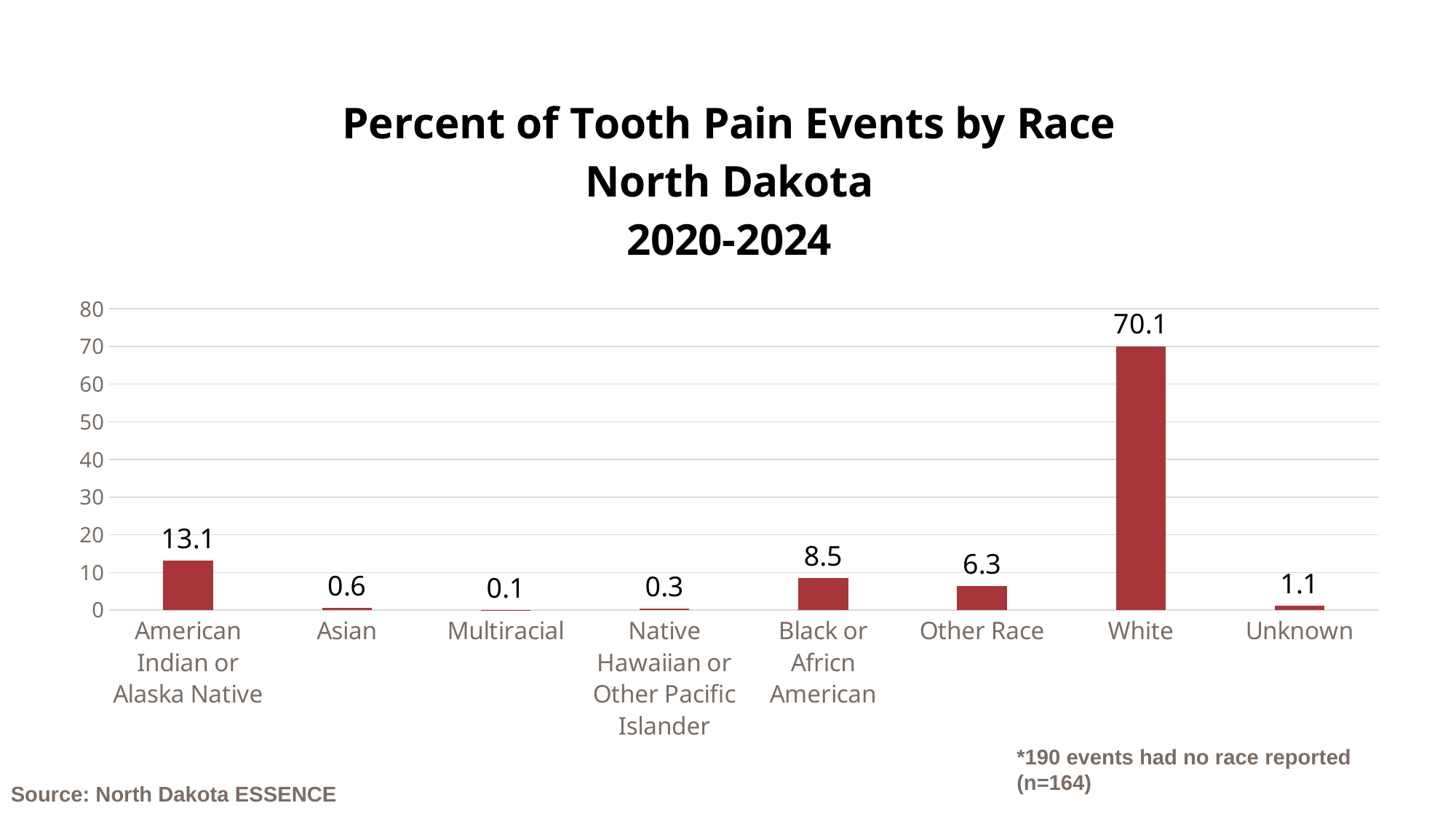
What is the value for White? 70.1 What kind of chart is shown on the slide? Bar chart Which race category has the lowest percent of tooth pain events? Multiracial What is the difference between the values for White and American Indian or Alaska Native? 57 What is the value for Black or Africn American? 8.5 How many race categories are shown on the x axis? 8 What is the title of the chart? Percent of Tooth Pain Events by Race North Dakota 2020-2024 Is the value for White greater or less than 60? greater Which race category has the highest percent of tooth pain events? White What is the value for American Indian or Alaska Native? 13.1 What is the value for Unknown? 1.1 Which is larger, the value for Black or Africn American or the value for Other Race? Black or Africn American